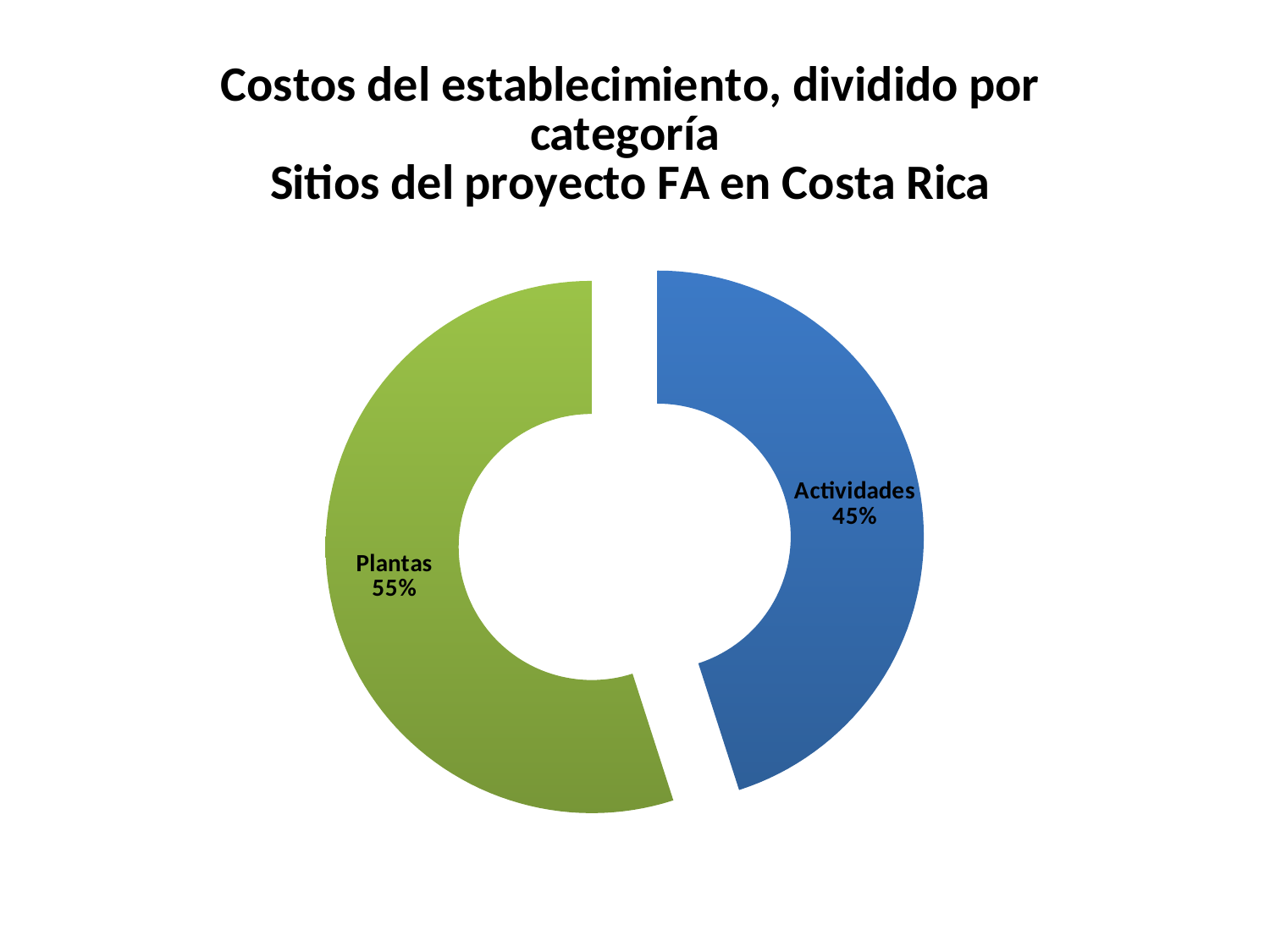
What share of establishment costs is attributed to Actividades? 45% What kind of chart is shown on the slide? Doughnut chart What colour is the Actividades segment? Blue Which category has the largest share of establishment costs? Plantas What share of establishment costs is attributed to Plantas? 55% Which is larger, the share for Plantas or the share for Actividades? Plantas How many categories are shown in the chart? 2 What colour is the Plantas segment? Green What is the combined share of Plantas and Actividades? 100% What is the difference in percentage points between the Plantas share and the Actividades share? 10 Which category has the smallest share of establishment costs? Actividades